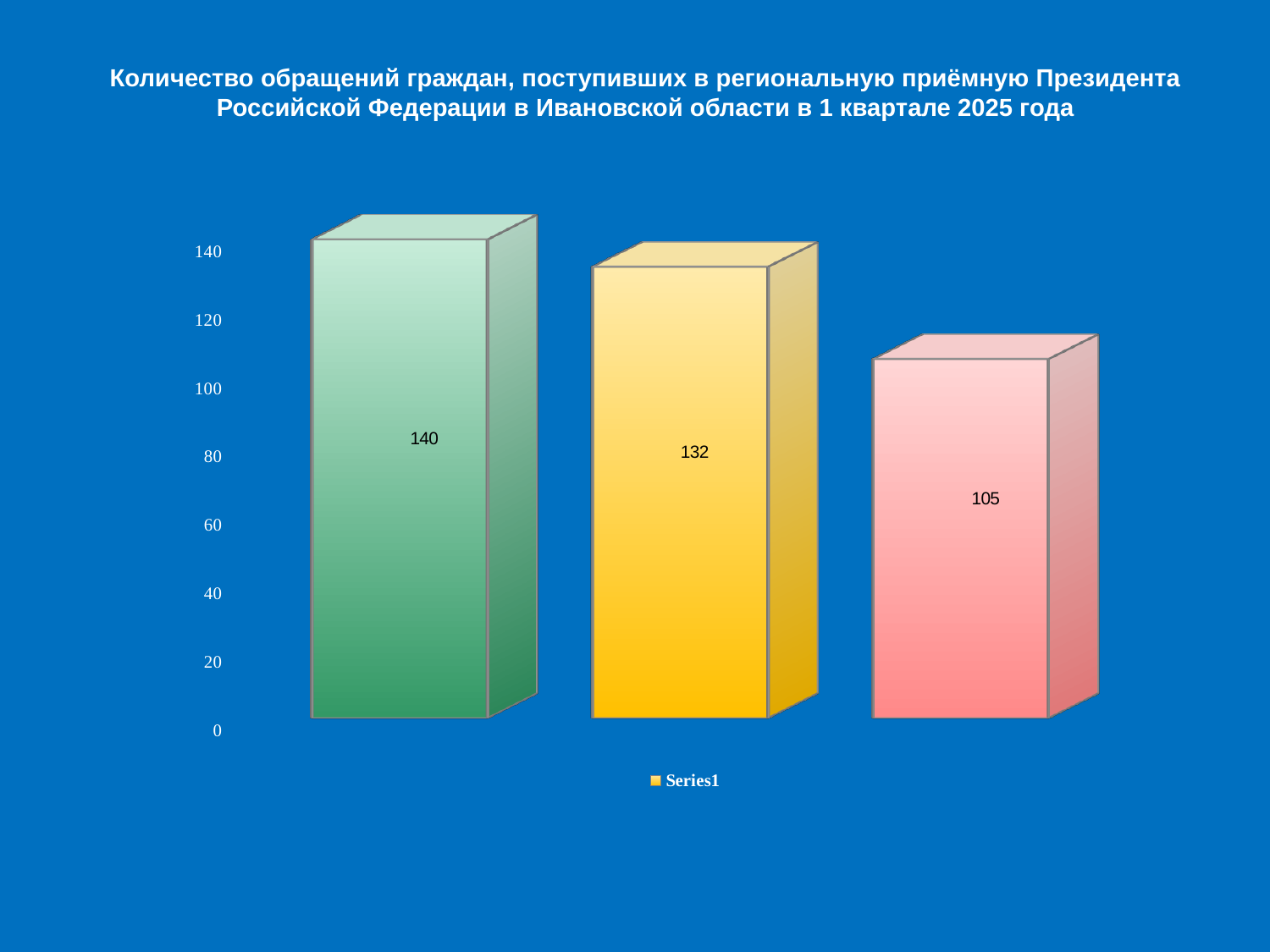
What is the difference between the first bar and the second bar? 8 What value is shown on the third (pink) bar? 105 What kind of chart is shown on the slide? bar chart How many bars are plotted on the chart? 3 How many series does the legend list? 1 Which bar has the highest value: the first, second or third? the first Which is larger, the value of the yellow bar or the pink bar? the yellow bar What is the difference between the first bar (140) and the third bar (105)? 35 Which bar has the lowest value: the first, second or third? the third Do the values rise or fall from left to right across the bars? fall What value is shown on the middle (yellow) bar? 132 What value is shown on the first (green) bar? 140